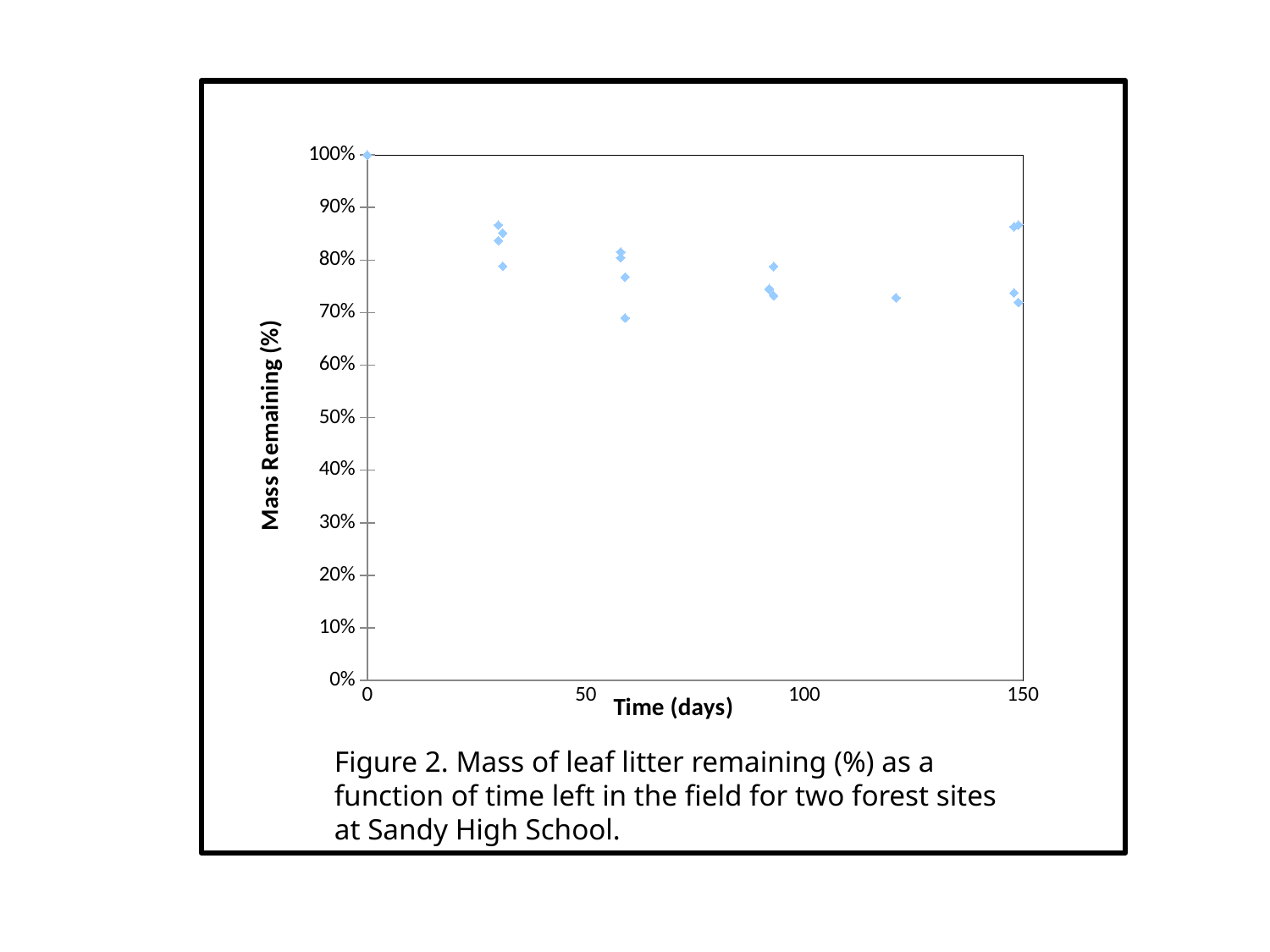
Is the value of the single point at about 120 days greater or less than 80%? less Are all the points at about 30 days greater or less than 70%? greater Are the highest points at about 150 days greater or less than 80%? greater What is the mass remaining value at 0 days? 100% What is the title of the x axis? Time (days) What kind of chart is shown on the slide? scatter chart What is the title of the y axis? Mass Remaining (%) Which time has the highest mass remaining value? 0 days Do the mass remaining values generally rise or fall as time increases from 0 days? fall